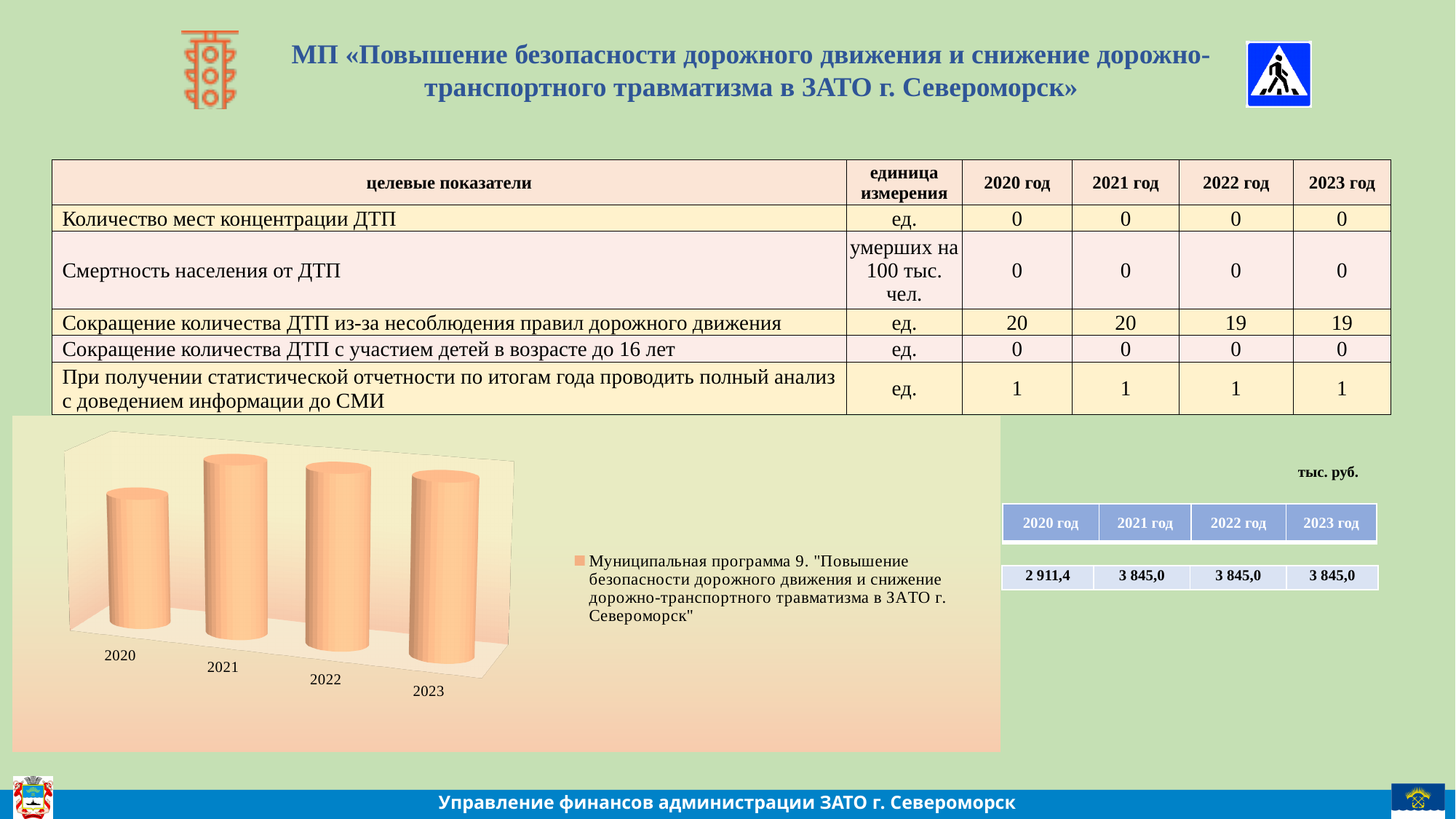
How many bars (years) does the bar chart show? 4 According to the table next to the bar chart, what is the value for 2021 год (тыс. руб.)? 3 845,0 Using the values in the table next to the bar chart, what is the difference between 2021 год and 2020 год (тыс. руб.)? 933,6 According to the table next to the bar chart, what is the value for 2020 год (тыс. руб.)? 2 911,4 In the bar chart, is the bar for 2020 or the bar for 2021 taller? 2021 According to the table next to the bar chart, what is the value for 2023 год (тыс. руб.)? 3 845,0 What unit is stated above the table next to the bar chart? тыс. руб. Do the bars in the bar chart rise or fall from 2020 to 2021? rise How many series does the legend of the bar chart list? 1 What kind of chart is shown at the bottom left of the slide? bar chart What is the first year label on the x axis of the bar chart? 2020 Which year has the lowest bar in the bar chart? 2020